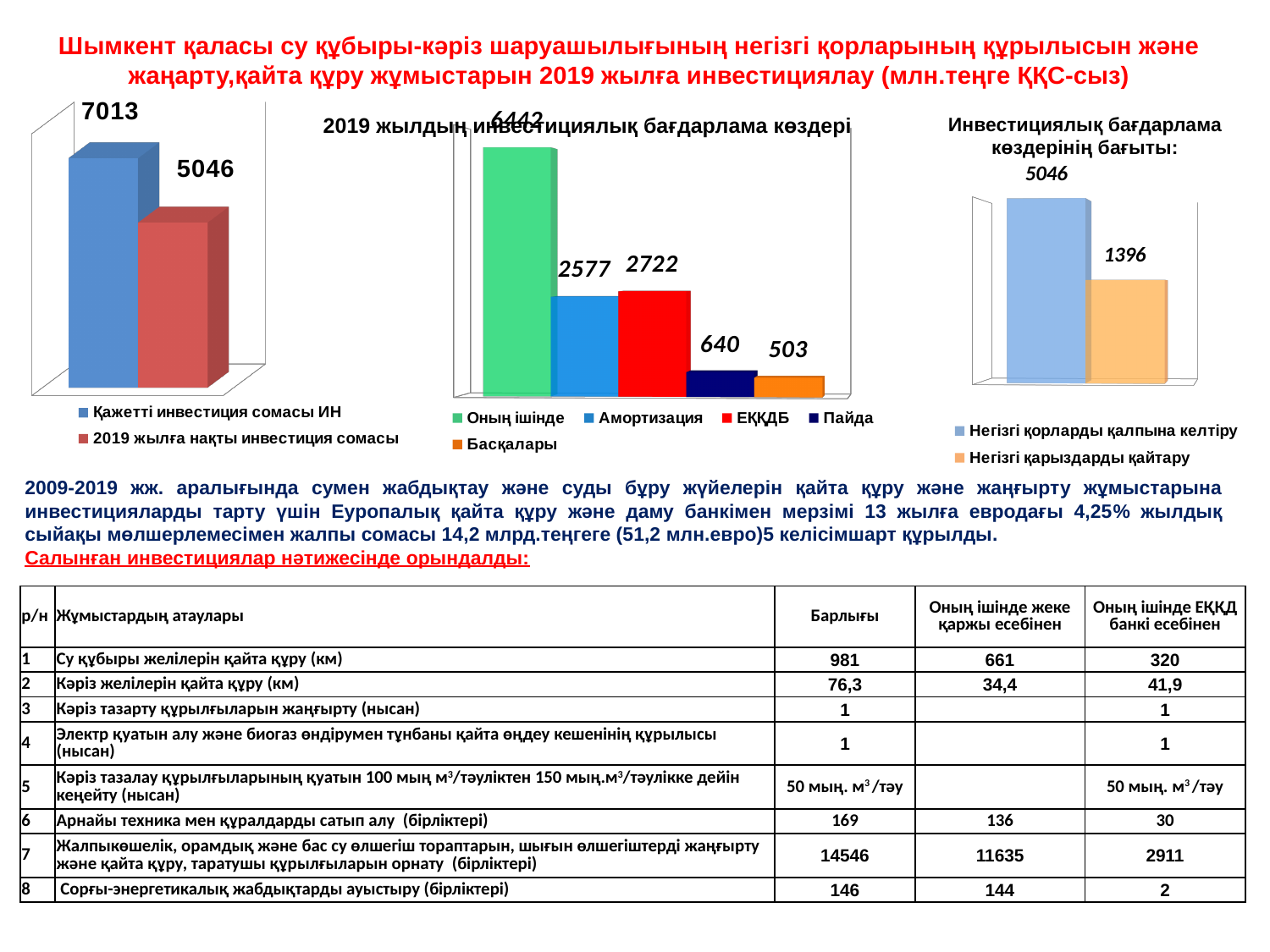
In the chart titled '2019 жылдың инвестициялық бағдарлама көздері', what is the value for ЕҚҚДБ? 2722 In the left chart, what is the value for 2019 жылға нақты инвестиция сомасы? 5046 In the left chart, how many series does the legend list? 2 What kind of chart is the chart titled 'Инвестициялық бағдарлама көздерінің бағыты'? bar chart In the chart titled 'Инвестициялық бағдарлама көздерінің бағыты', what is the value for Негізгі қарыздарды қайтару? 1396 In the left chart, what is the value for Қажетті инвестиция сомасы ИН? 7013 In the chart titled '2019 жылдың инвестициялық бағдарлама көздері', what is the value for Пайда? 640 In the chart titled '2019 жылдың инвестициялық бағдарлама көздері', what is the value for Амортизация? 2577 In the chart titled '2019 жылдың инвестициялық бағдарлама көздері', which is larger, Амортизация or ЕҚҚДБ? ЕҚҚДБ In the chart titled '2019 жылдың инвестициялық бағдарлама көздері', how many series does the legend list? 5 In the chart titled '2019 жылдың инвестициялық бағдарлама көздері', which series has the lowest value? Басқалары In the left chart, what is the difference between Қажетті инвестиция сомасы ИН and 2019 жылға нақты инвестиция сомасы? 1967